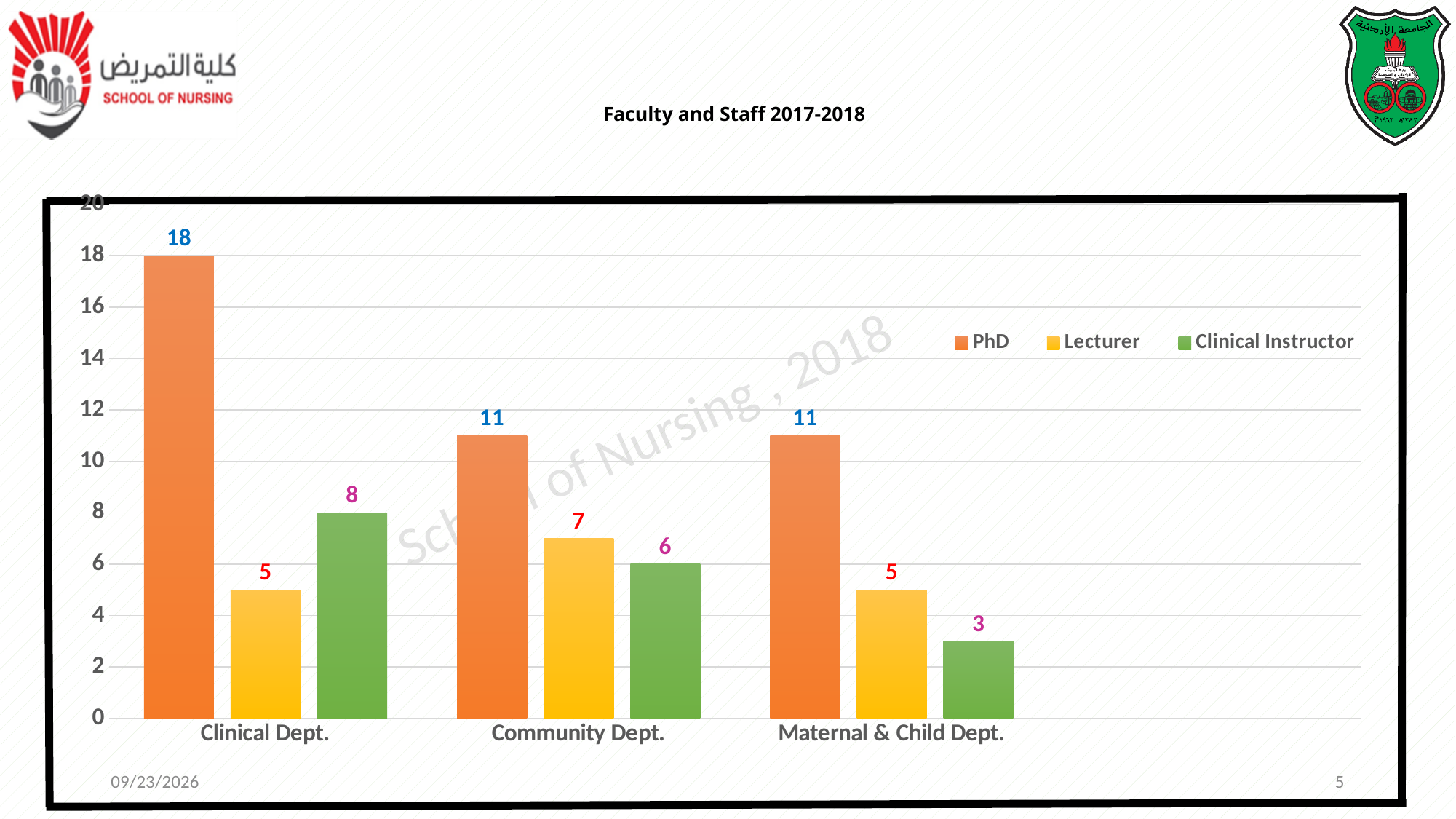
What is the PhD value for Clinical Dept.? 18 How many departments are shown on the x axis? 3 Which series is shown in green in the legend? Clinical Instructor What is the difference between the PhD value and the Lecturer value for Clinical Dept.? 13 What is the Lecturer value for Community Dept.? 7 Which is larger for Community Dept., the Lecturer value or the Clinical Instructor value? Lecturer Which department has the highest PhD value? Clinical Dept. Which department has the lowest Clinical Instructor value? Maternal & Child Dept. What is the title of the chart? Faculty and Staff 2017-2018 How many series does the legend list? 3 What kind of chart is shown on the slide? Bar chart What is the Clinical Instructor value for Maternal & Child Dept.? 3